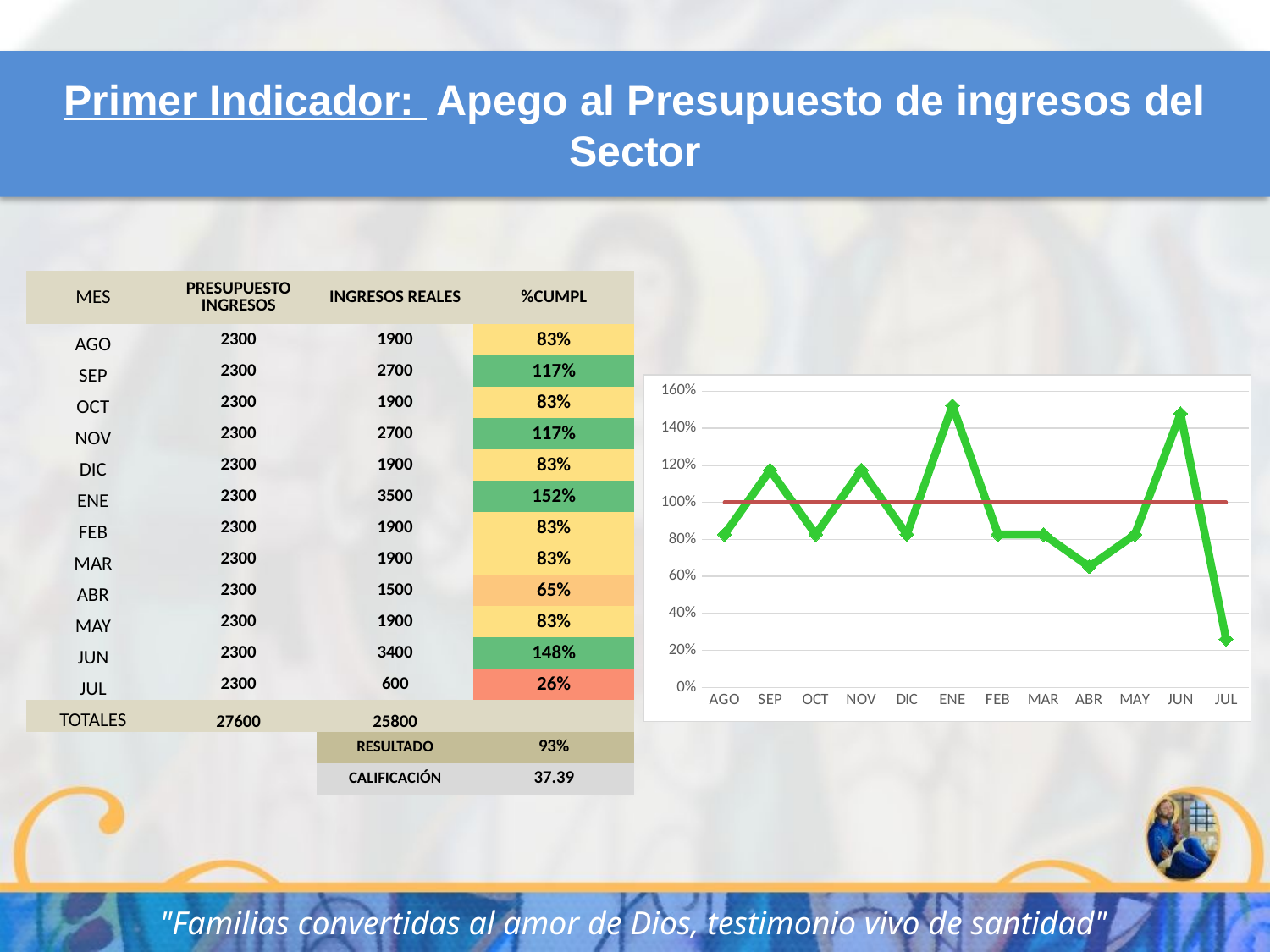
What is the %CUMPL value plotted for ENE? 152% At what level is the horizontal red reference line drawn on the chart? 100% Which is larger on the chart, the value for SEP or the value for OCT? SEP Is the value for ABR on the chart greater or less than 80%? less Does the line rise or fall from JUN to JUL? fall Which month has the lowest value on the chart? JUL Is the value for ENE on the chart greater or less than 140%? greater Which is larger on the chart, the value for ABR or the value for MAY? MAY Is the value for SEP on the chart greater or less than 100%? greater What kind of chart is shown on the slide? line chart How many months are plotted along the x axis of the chart? 12